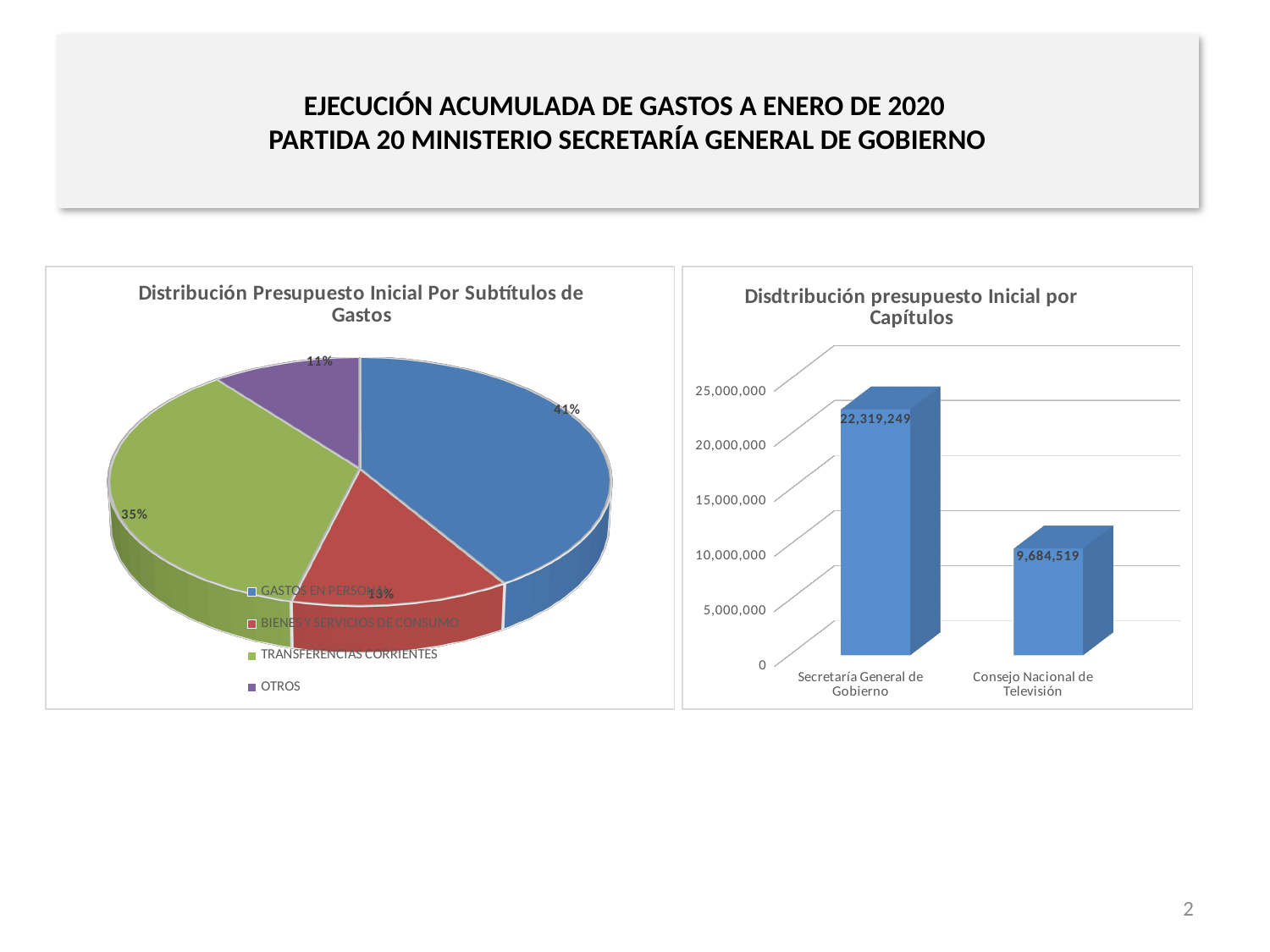
In the pie chart 'Distribución Presupuesto Inicial Por Subtítulos de Gastos', what share does GASTOS EN PERSONAL have? 41% In the chart 'Disdtribución presupuesto Inicial por Capítulos', what is the value for Consejo Nacional de Televisión? 9,684,519 In the pie chart 'Distribución Presupuesto Inicial Por Subtítulos de Gastos', what share does OTROS have? 11% In the pie chart 'Distribución Presupuesto Inicial Por Subtítulos de Gastos', how many categories does the legend list? 4 In the pie chart 'Distribución Presupuesto Inicial Por Subtítulos de Gastos', which category has the smallest share? OTROS In the pie chart 'Distribución Presupuesto Inicial Por Subtítulos de Gastos', what share does TRANSFERENCIAS CORRIENTES have? 35% In the chart 'Disdtribución presupuesto Inicial por Capítulos', is the value for Consejo Nacional de Televisión greater or less than 10,000,000? less In the pie chart 'Distribución Presupuesto Inicial Por Subtítulos de Gastos', what colour is the TRANSFERENCIAS CORRIENTES slice? Green What kind of chart is the chart on the right of the slide, 'Disdtribución presupuesto Inicial por Capítulos'? Bar chart In the pie chart 'Distribución Presupuesto Inicial Por Subtítulos de Gastos', which category has the largest share? GASTOS EN PERSONAL In the chart 'Disdtribución presupuesto Inicial por Capítulos', what is the difference between Secretaría General de Gobierno and Consejo Nacional de Televisión? 12,634,730 In the chart 'Disdtribución presupuesto Inicial por Capítulos', what is the value for Secretaría General de Gobierno? 22,319,249